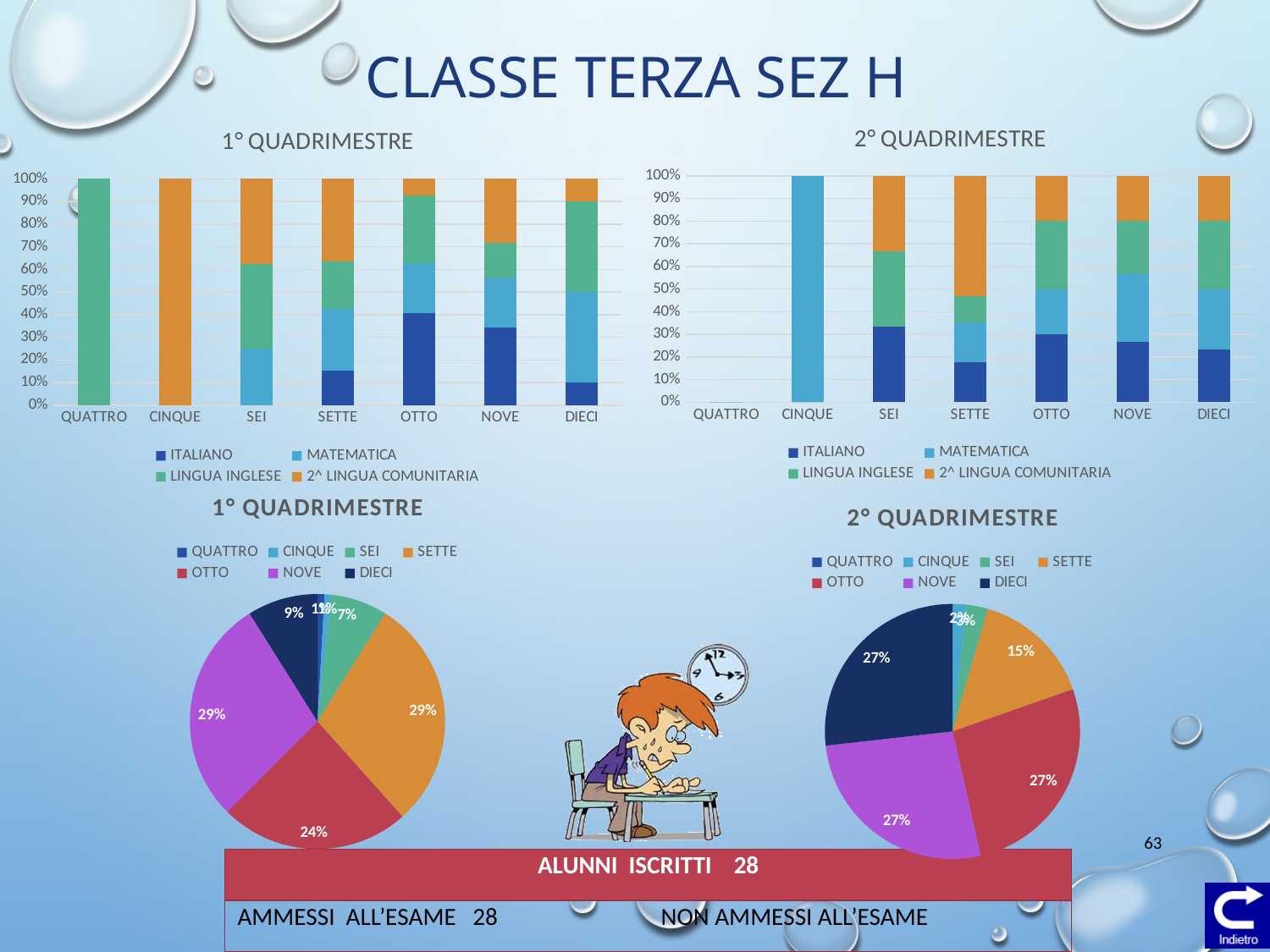
In the bottom-right '2° QUADRIMESTRE' pie chart, which is larger, the share for SETTE or the share for OTTO? OTTO In the top-left '1° QUADRIMESTRE' bar chart, which series makes up the entire bar for QUATTRO? LINGUA INGLESE In the bottom-left '1° QUADRIMESTRE' pie chart, what share does DIECI have? 9% How many categories are shown on the x axis of the top-left '1° QUADRIMESTRE' bar chart? 7 In the top-left '1° QUADRIMESTRE' bar chart, is the ITALIANO value for OTTO greater or less than 30%? greater In the bottom-right '2° QUADRIMESTRE' pie chart, what share does SETTE have? 15% In the bottom-left '1° QUADRIMESTRE' pie chart, what share does SETTE have? 29% What kind of chart is the top-left '1° QUADRIMESTRE' chart? Stacked bar chart In the top-right '2° QUADRIMESTRE' bar chart, is the ITALIANO value for SEI greater or less than 20%? greater In the top-right '2° QUADRIMESTRE' bar chart, which series makes up the entire bar for CINQUE? MATEMATICA In the bottom-left '1° QUADRIMESTRE' pie chart, what is the difference between the SETTE share and the OTTO share? 5 percentage points How many series does the legend of the top-right '2° QUADRIMESTRE' bar chart list? 4